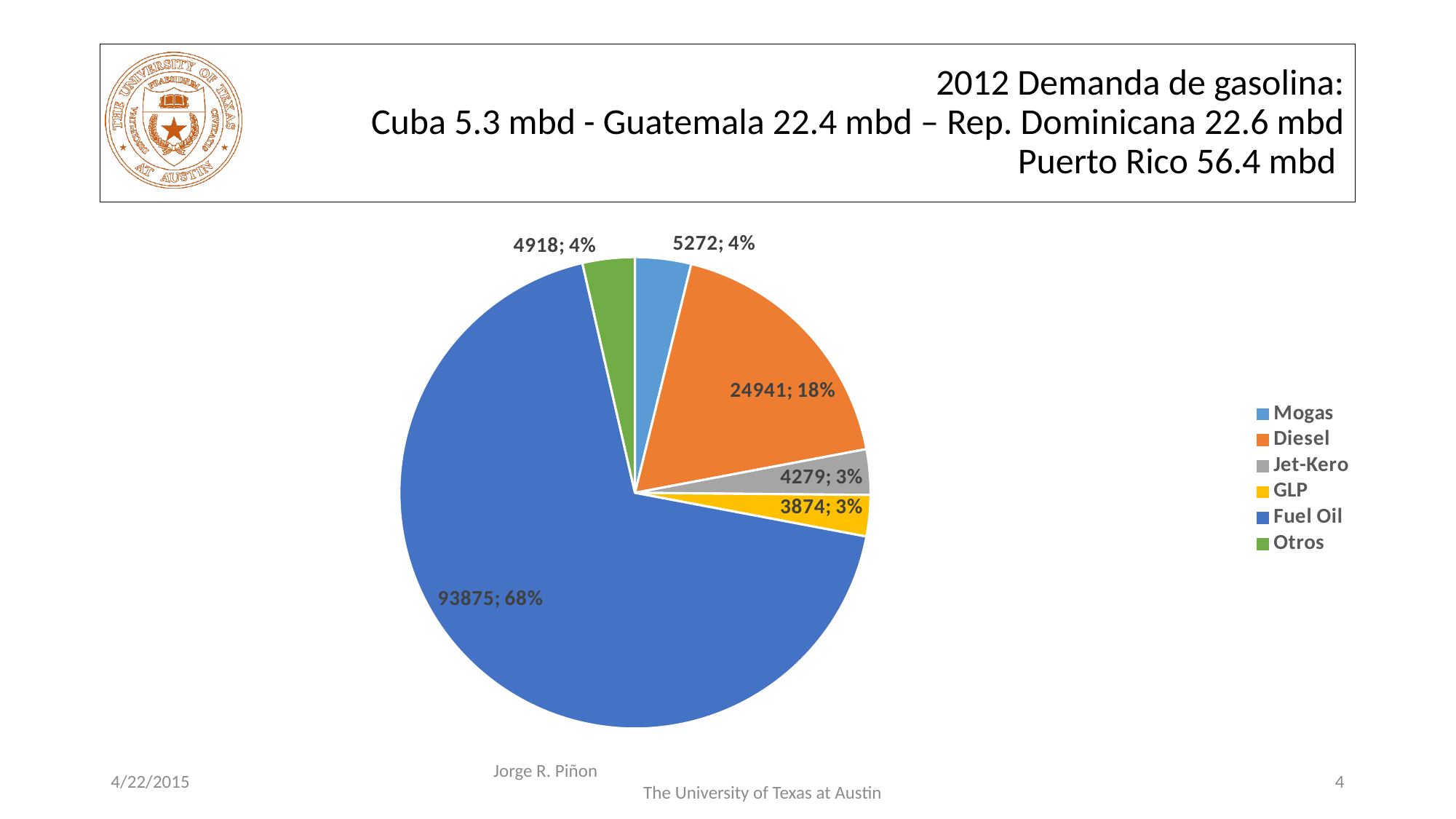
Which is larger, the value for Mogas or the value for Otros? Mogas What share of the pie does Diesel represent? 18% What value is shown for the Diesel slice of the pie chart? 24941 How many slices does the pie chart have? 6 What share of the pie does Fuel Oil represent? 68% Which category has the largest slice of the pie chart? Fuel Oil What kind of chart is shown on the slide? Pie chart What value is shown for the Jet-Kero slice of the pie chart? 4279 What is the difference between the Diesel value and the Mogas value? 19669 Which category has the smallest slice of the pie chart? GLP What value is shown for the Fuel Oil slice of the pie chart? 93875 What is the difference between the Jet-Kero value and the GLP value? 405